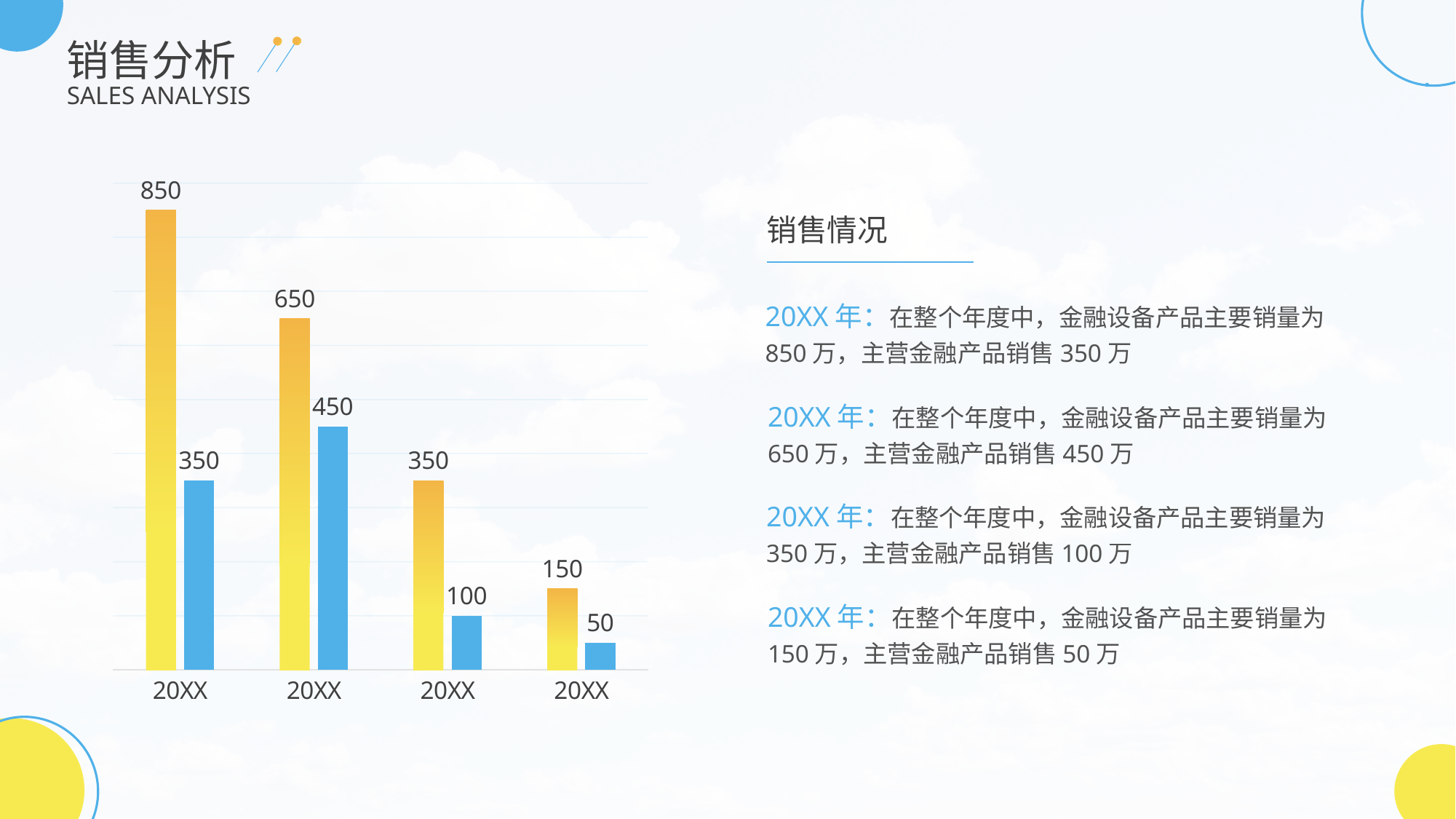
What is the difference between the blue bar of the second category and the blue bar of the third category? 350 What is the value of the yellow bar for the first (leftmost) category? 850 Do the values of the yellow bars rise or fall from left to right along the x axis? fall What type of chart is shown on the slide? bar chart What is the value of the yellow bar for the third category from the left? 350 Which bar has the highest value in the chart? the yellow bar of the first (leftmost) category, 850 What is the value of the blue bar for the second category from the left? 450 What is the lowest value shown in the chart? 50 What is the value of the blue bar for the fourth (rightmost) category? 50 What is the difference between the yellow bar and the blue bar in the first (leftmost) category? 500 In the second category from the left, which is larger, the yellow bar or the blue bar? the yellow bar How many categories are shown along the x axis of the chart? 4